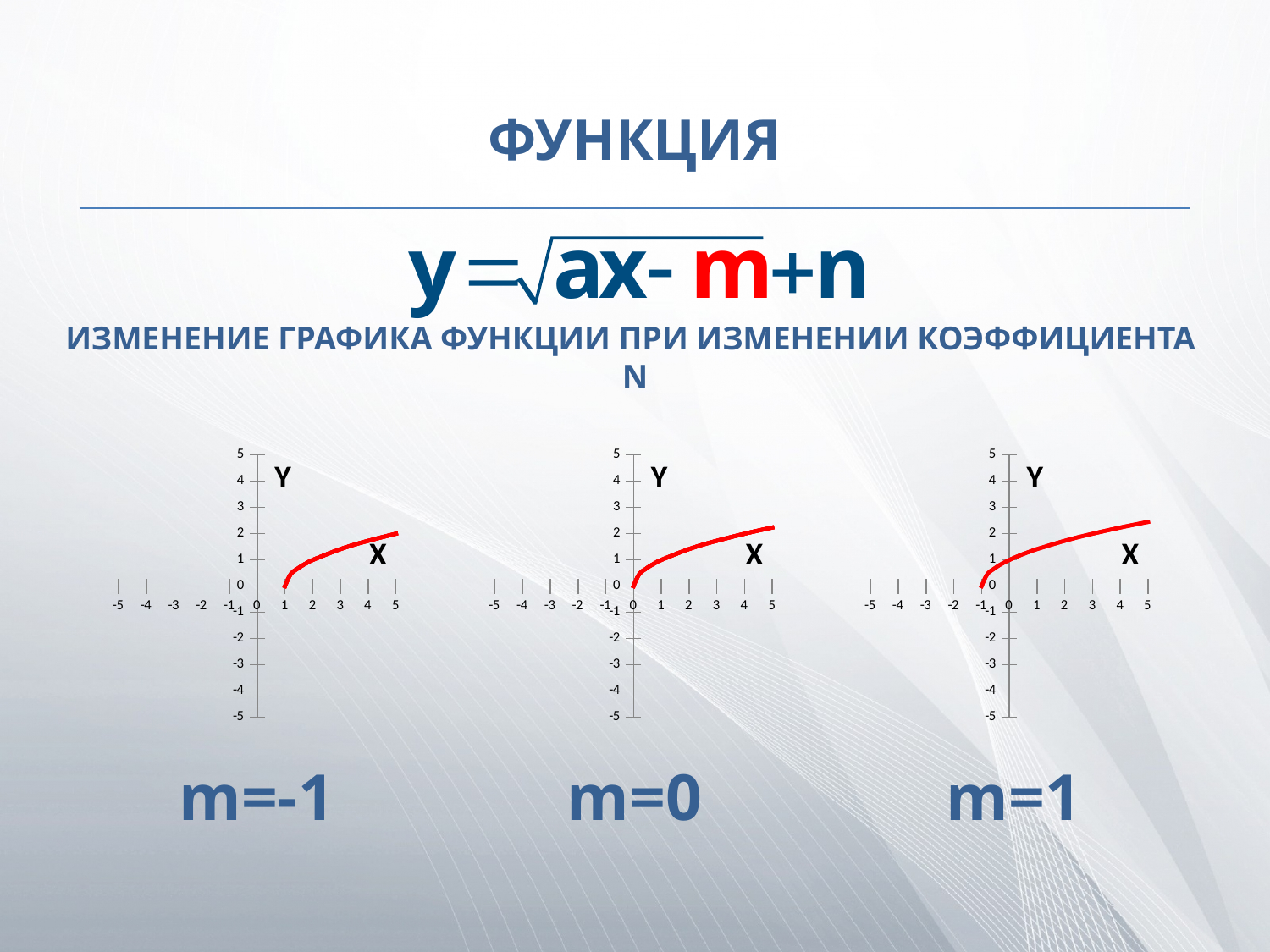
How many charts are shown on the slide? 3 In the middle chart (m=0), does the red curve rise or fall along the x axis? rise In the left chart (m=-1), at which x value does the red curve start on the x axis? 1 What colour is the plotted curve in the right chart (m=1)? red In the left chart (m=-1), is the value of the curve at x=5 greater or less than 1? greater In the middle chart (m=0), at which x value does the red curve start? 0 What kind of chart is the left chart labelled m=-1? line chart In the right chart (m=1), is the value of the curve at x=5 greater or less than 1? greater In the left chart (m=-1), does the red curve rise or fall as x increases? rise In the left chart (m=-1), is the value of the curve at x=5 greater or less than 3? less In the right chart (m=1), at which x value does the red curve start on the x axis? -1 What is the range of the y axis in the middle chart (m=0)? -5 to 5